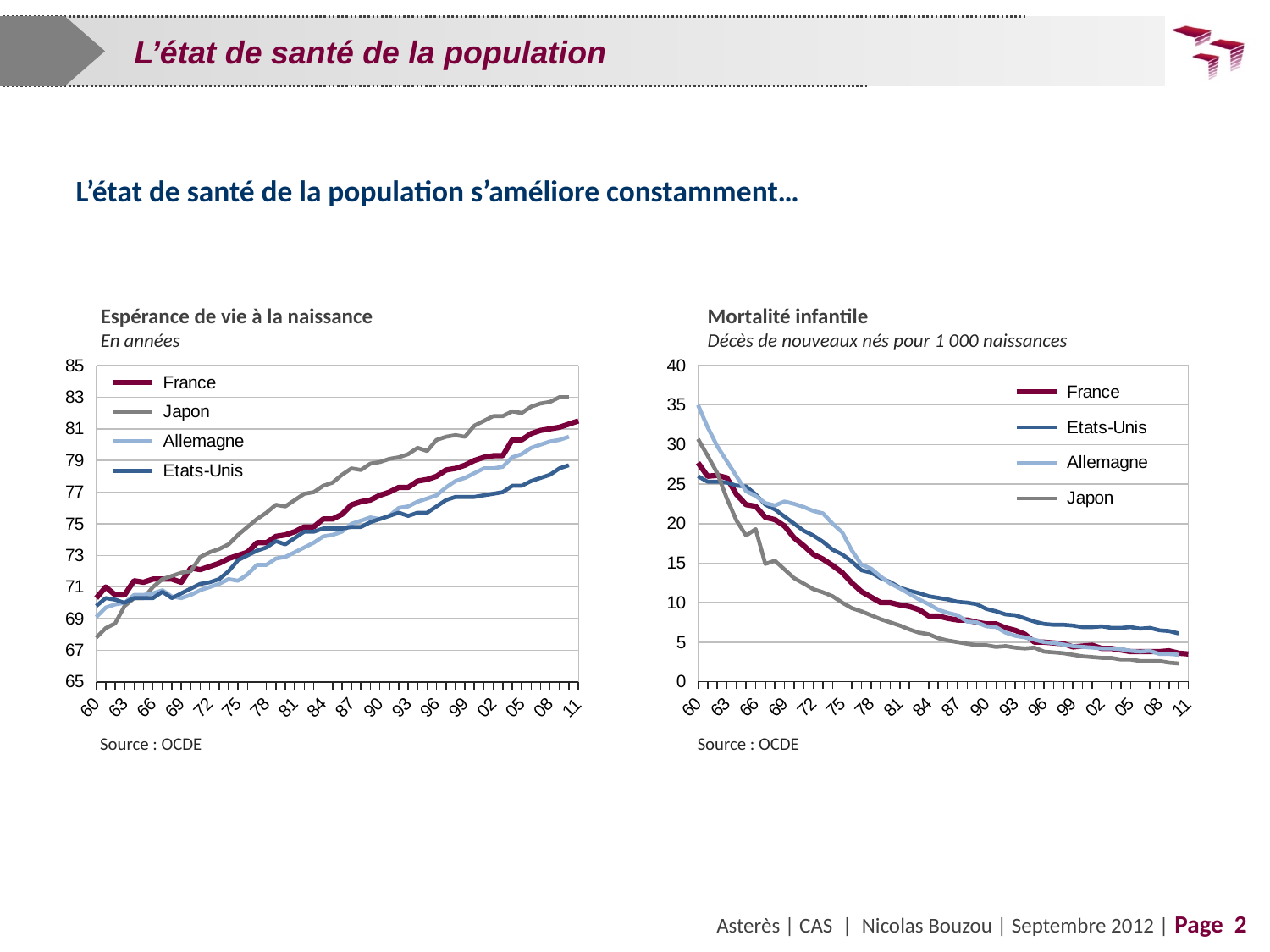
In the 'Mortalité infantile' chart, is the value for Etats-Unis in 2011 greater or less than 5? greater How many series does the legend of the 'Mortalité infantile' chart list? 4 What kind of chart is the 'Espérance de vie à la naissance' chart? line chart In the 'Mortalité infantile' chart, do the values rise or fall from 1960 to 2011? fall In the 'Espérance de vie à la naissance' chart, which country has the highest life expectancy in 2011? Japon In the 'Espérance de vie à la naissance' chart, is the value for Etats-Unis in 2011 greater or less than 80? less In the 'Mortalité infantile' chart, which country has the lowest infant mortality in 2011? Japon In the 'Mortalité infantile' chart, which country has the highest infant mortality in 1960? Allemagne In the 'Espérance de vie à la naissance' chart, is the value for Japon in 1960 greater or less than 70? less What source is cited below both charts? OCDE In the 'Espérance de vie à la naissance' chart, do the values rise or fall from 1960 to 2011? rise In the 'Espérance de vie à la naissance' chart, which country has the lowest life expectancy in 2011? Etats-Unis